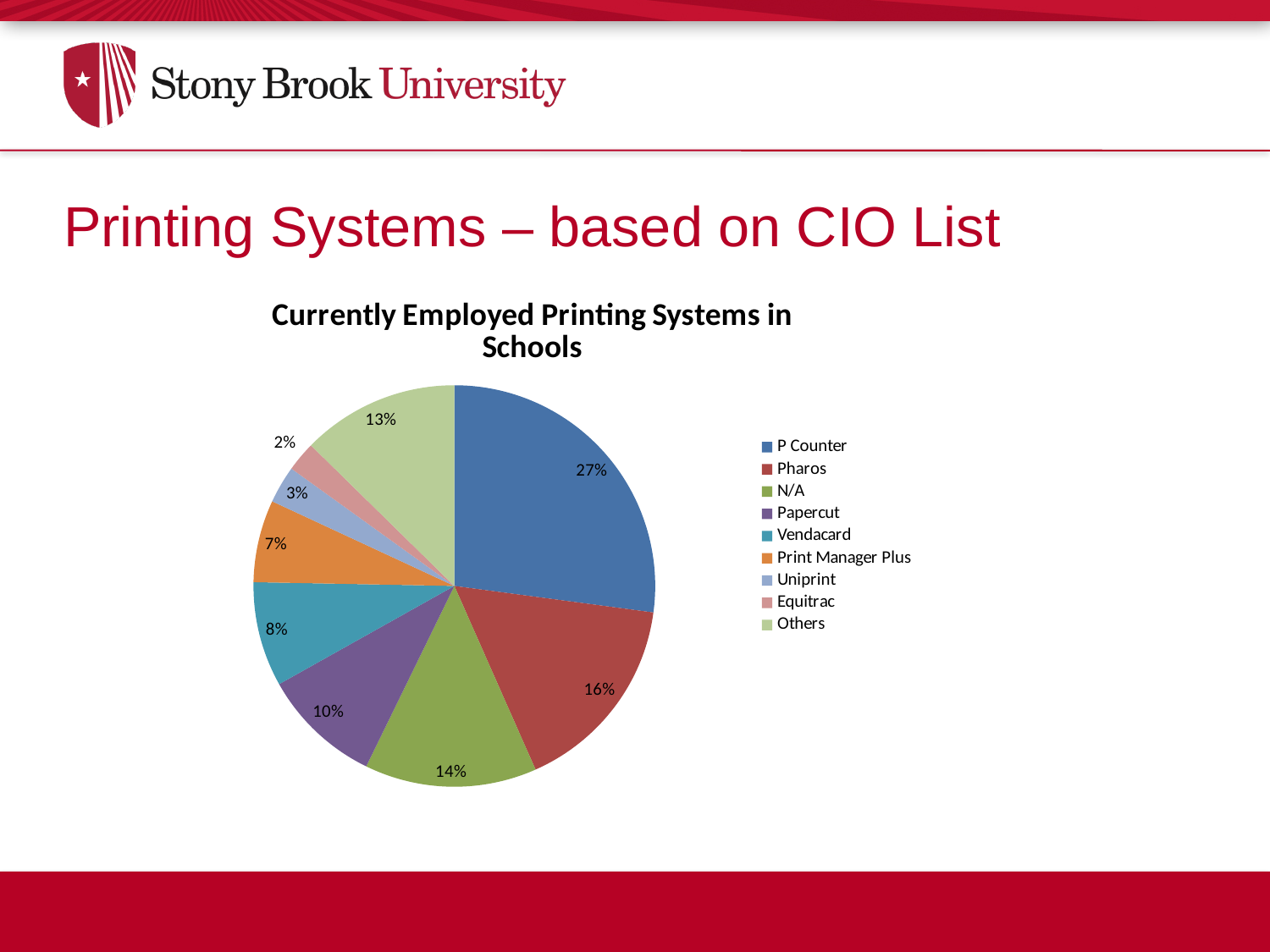
Which has a larger share, Vendacard or Print Manager Plus? Vendacard What is the title of the chart? Currently Employed Printing Systems in Schools What type of chart is shown on the slide? pie chart Which printing system has the smallest slice of the pie? Equitrac What percentage is shown for Others? 13% What is the difference in percentage points between P Counter and Pharos? 11 Which printing system has the largest slice of the pie? P Counter What percentage is shown for Pharos? 16% How many categories does the legend list? 9 What share of the pie does P Counter hold? 27% What percentage is shown for Papercut? 10% What percentage is shown for Uniprint? 3%